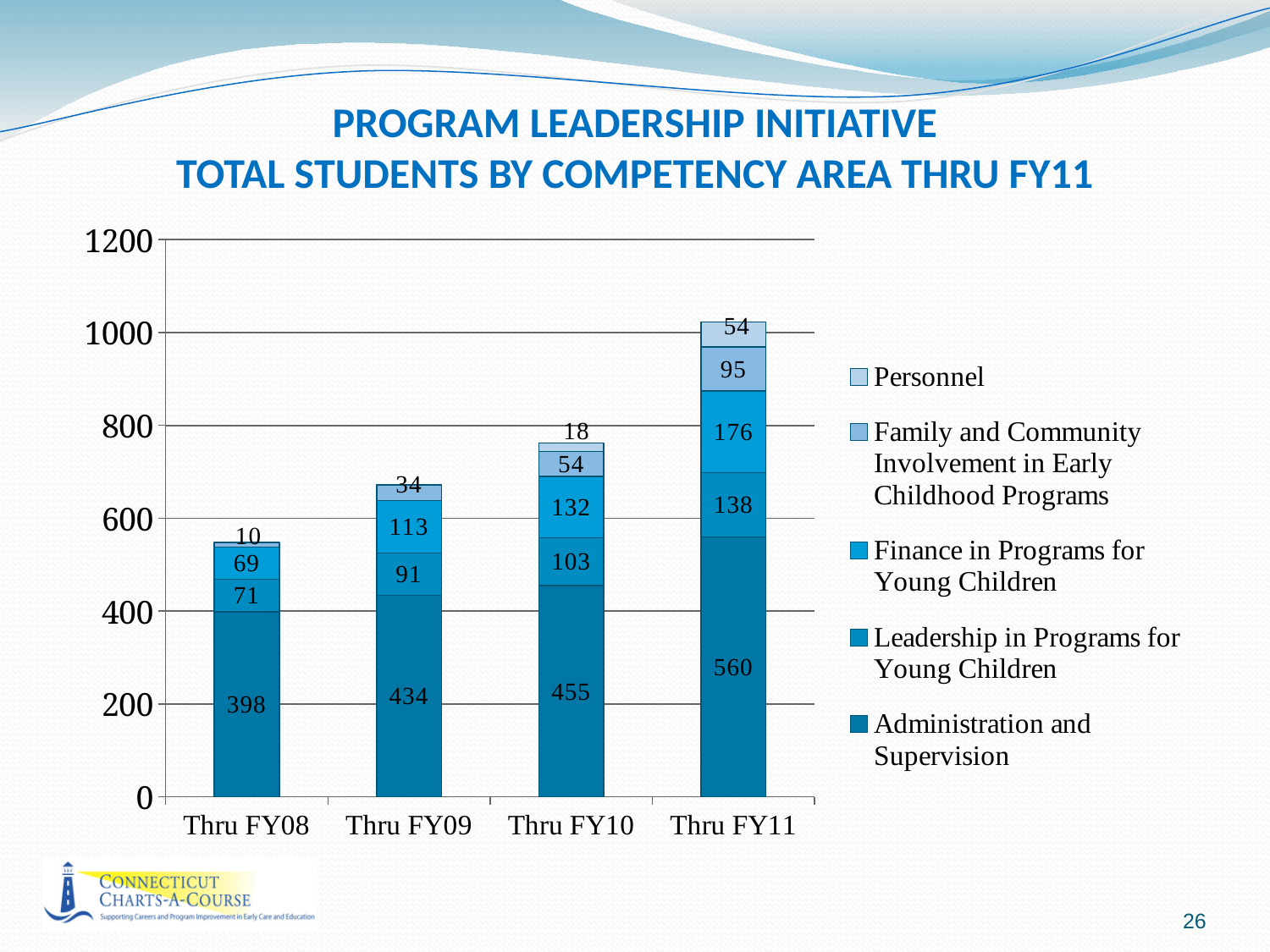
What is the value for Personnel in the Thru FY11 bar? 54 What is the value for Finance in Programs for Young Children in the Thru FY09 bar? 113 Which category has the shortest stacked bar? Thru FY08 How many series does the legend list? 5 In the Thru FY11 bar, which is larger: Finance in Programs for Young Children or Leadership in Programs for Young Children? Finance in Programs for Young Children What is the value for Leadership in Programs for Young Children in the Thru FY10 bar? 103 How much larger is the Administration and Supervision value for Thru FY11 than for Thru FY08? 162 What is the total of the stacked bar for Thru FY11? 1023 Which category has the tallest stacked bar? Thru FY11 What is the value for Administration and Supervision in the Thru FY11 bar? 560 What is the total of the stacked bar for Thru FY08? 548 Do the total bar heights rise or fall from Thru FY08 to Thru FY11? rise